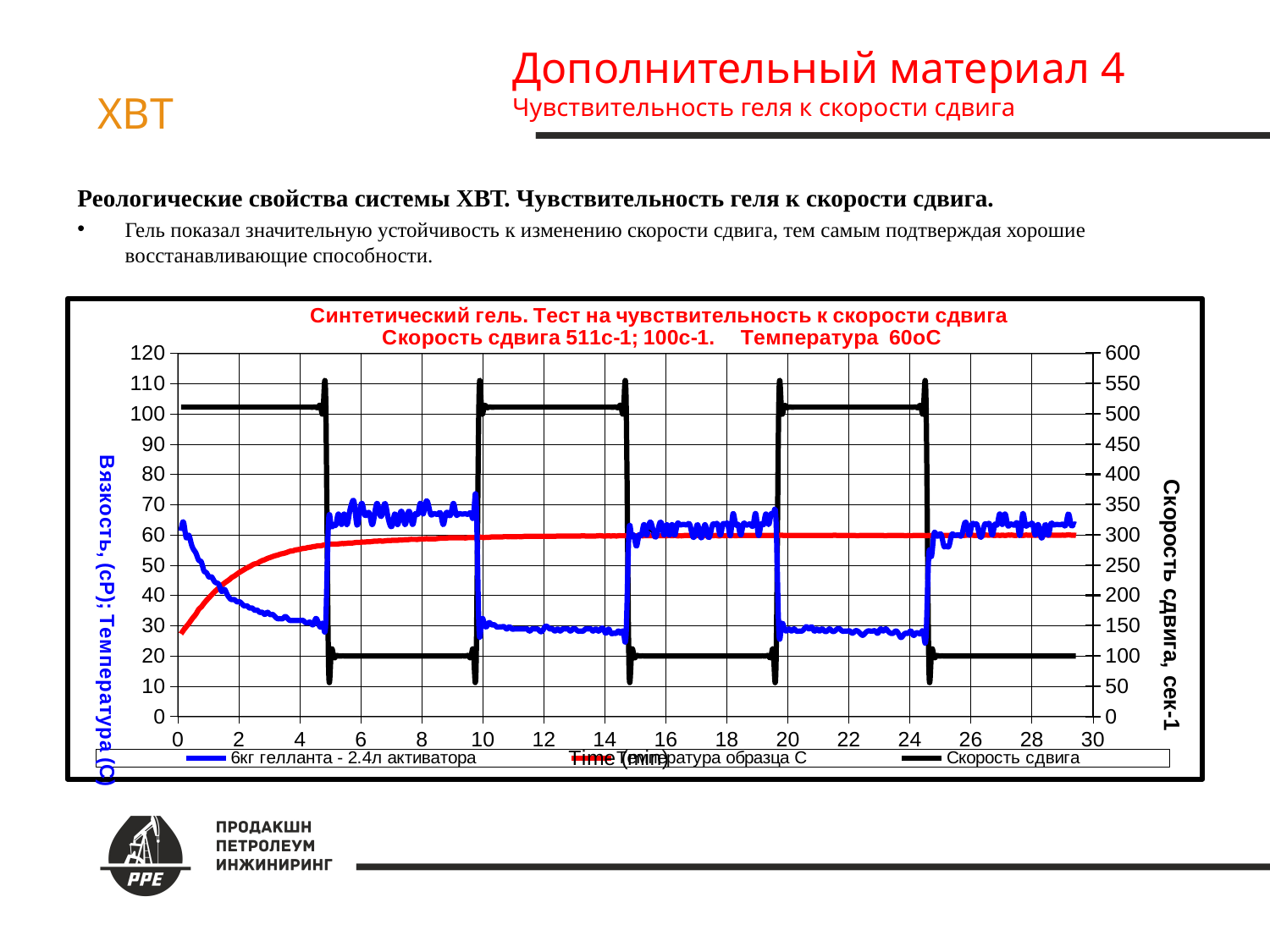
What is the last tick value on the Time (min) axis? 30 How many series does the chart legend list? 3 What kind of chart is shown on the slide? line chart Is the value of the Температура образца C series at the start of the test (time 0) greater or less than 40? less What is the title of the chart (first line)? Синтетический гель. Тест на чувствительность к скорости сдвига Is the value of the Температура образца C series at the end of the test (around 29 min) greater or less than 50? greater What is the maximum value shown on the right-hand axis (Скорость сдвига, сек-1)? 600 Is the value of the Скорость сдвига series during its low periods (e.g. around 7 min) greater or less than 150 on the right axis? less Which series is drawn in black according to the legend? Скорость сдвига Does the Температура образца C series rise or fall along the time axis? rise What is the maximum value shown on the left-hand axis? 120